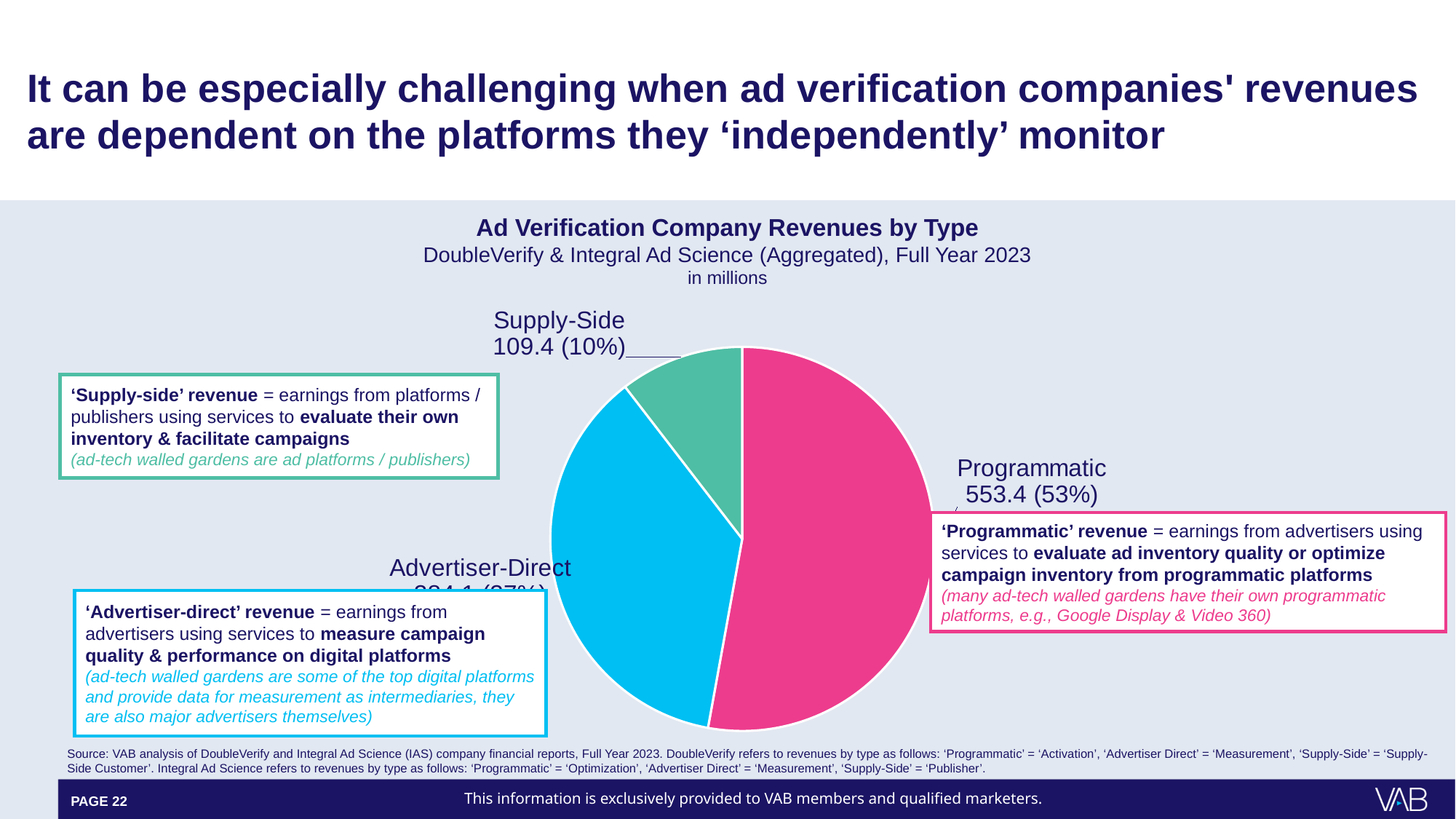
What share of the pie does the Supply-Side slice represent? 10% Which is larger, the Programmatic revenue or the Supply-Side revenue? Programmatic In what unit are the chart's values expressed? in millions Which revenue type has the smallest slice of the pie? Supply-Side What is the revenue value shown for Programmatic? 553.4 What is the difference between the Programmatic revenue and the Supply-Side revenue? 444.0 What is the revenue value shown for Supply-Side? 109.4 How many revenue types (slices) are shown in the pie chart? 3 What is the title of the chart? Ad Verification Company Revenues by Type What share of the pie does the Programmatic slice represent? 53% Which revenue type has the largest slice of the pie? Programmatic What kind of chart is shown on the slide? Pie chart